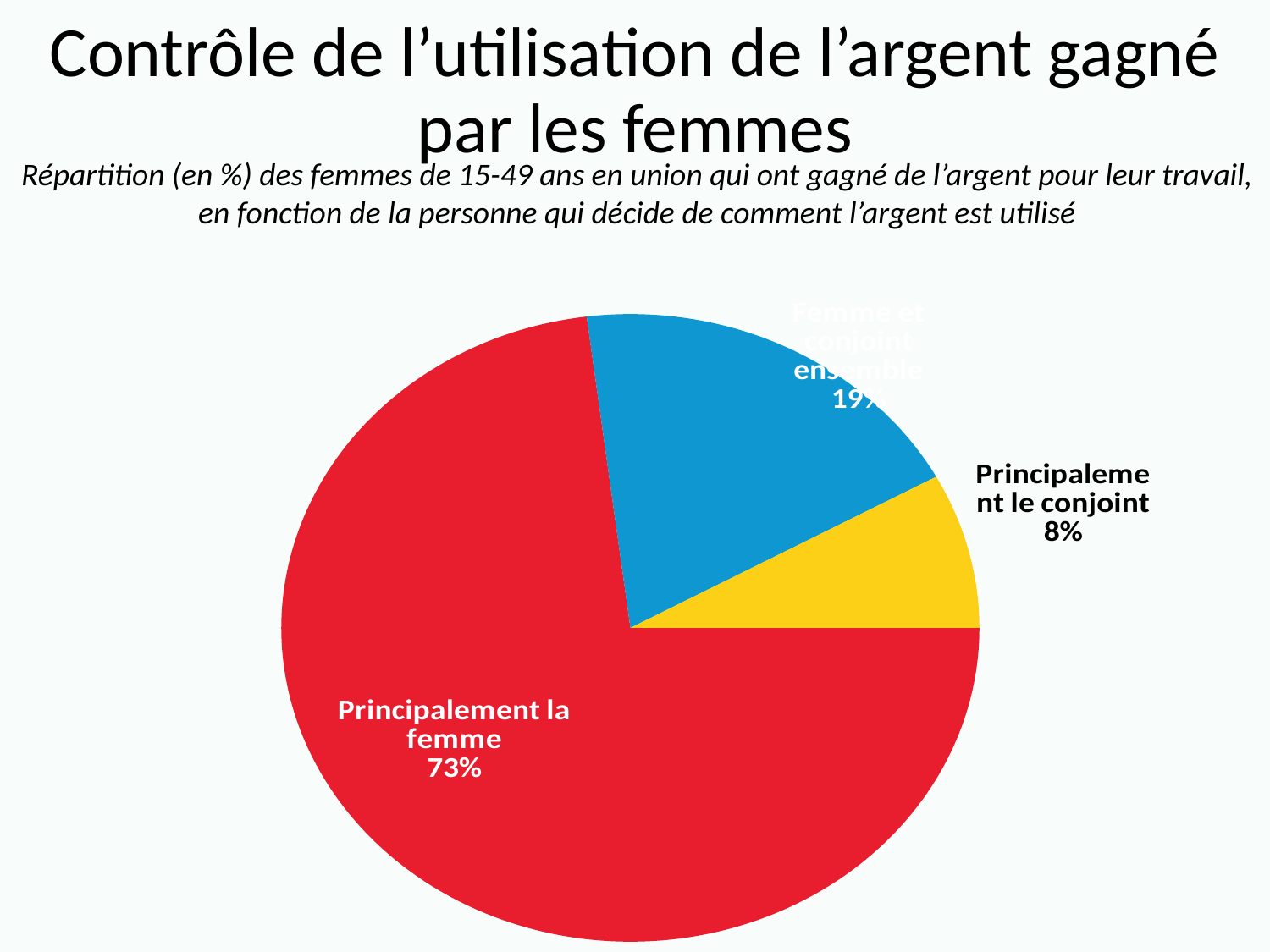
Which category has the largest share of the pie? Principalement la femme Which category has the smallest share of the pie? Principalement le conjoint How many slices does the pie chart have? 3 What percentage corresponds to 'Femme et conjoint ensemble'? 19% What colour is the slice for 'Principalement le conjoint'? Yellow What is the difference in percentage points between 'Femme et conjoint ensemble' and 'Principalement le conjoint'? 11 What kind of chart is shown on the slide? Pie chart What percentage of women report that mainly the woman herself (Principalement la femme) decides how the money is used? 73% What colour is the slice for 'Principalement la femme'? Red Which is larger: the share for 'Femme et conjoint ensemble' or the share for 'Principalement le conjoint'? Femme et conjoint ensemble What is the difference in percentage points between 'Principalement la femme' and 'Principalement le conjoint'? 65 What percentage corresponds to 'Principalement le conjoint'? 8%